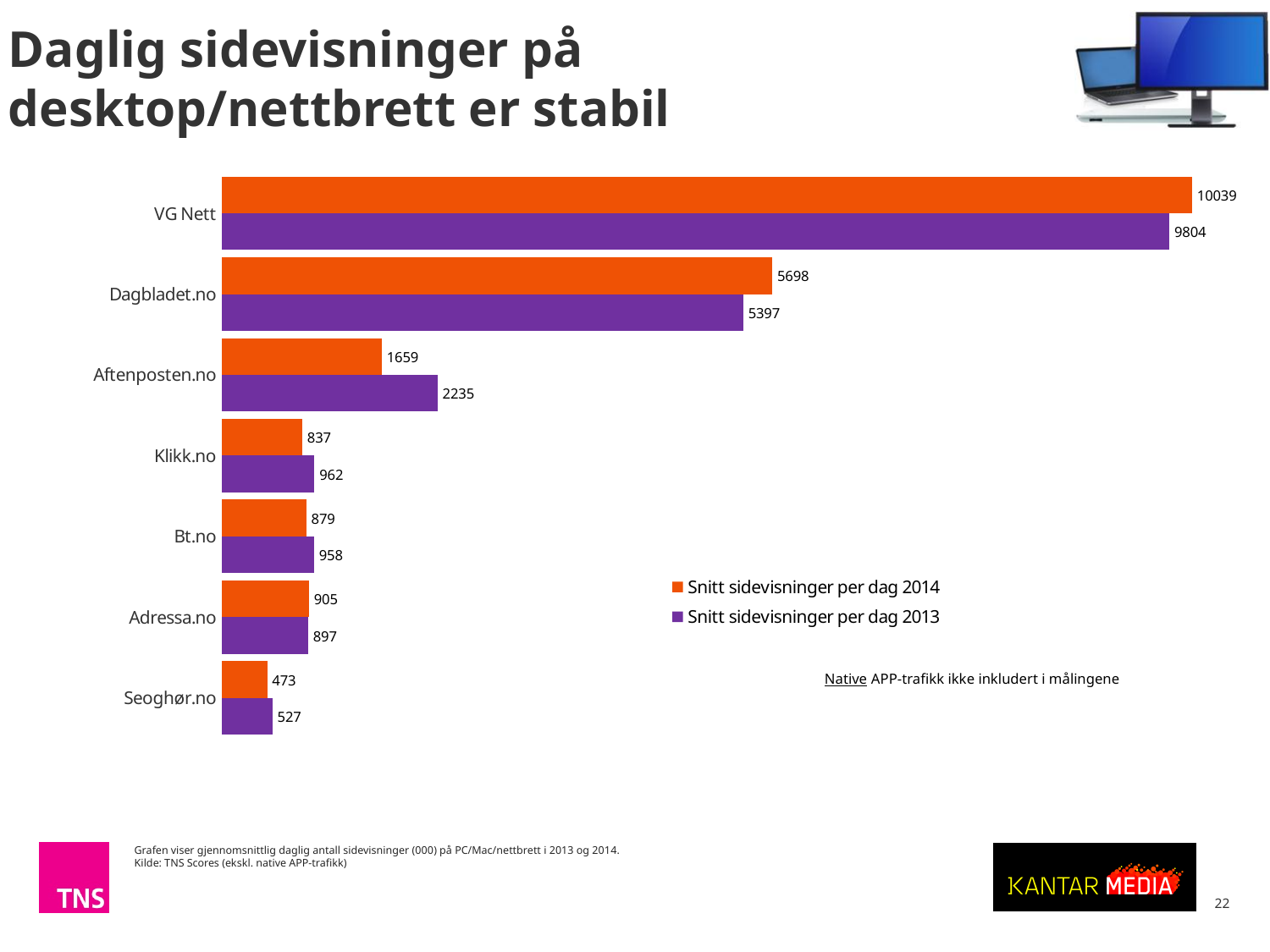
How many categories are shown on the chart? 7 What is the difference between the 2014 and 2013 values for Dagbladet.no? 301 Which category has the lowest value in the series 'Snitt sidevisninger per dag 2014'? Seoghør.no Which colour represents the series 'Snitt sidevisninger per dag 2013'? Purple How many series does the legend list? 2 What is the value for Aftenposten.no in the series 'Snitt sidevisninger per dag 2013'? 2235 What kind of chart is shown on the slide? Bar chart What is the value for Seoghør.no in the series 'Snitt sidevisninger per dag 2014'? 473 What is the difference between the 2013 and 2014 values for Aftenposten.no? 576 What is the value for VG Nett in the series 'Snitt sidevisninger per dag 2014'? 10039 Which category has the highest value in the series 'Snitt sidevisninger per dag 2013'? VG Nett For Klikk.no, which is larger: the 2014 value or the 2013 value? 2013 value (962)